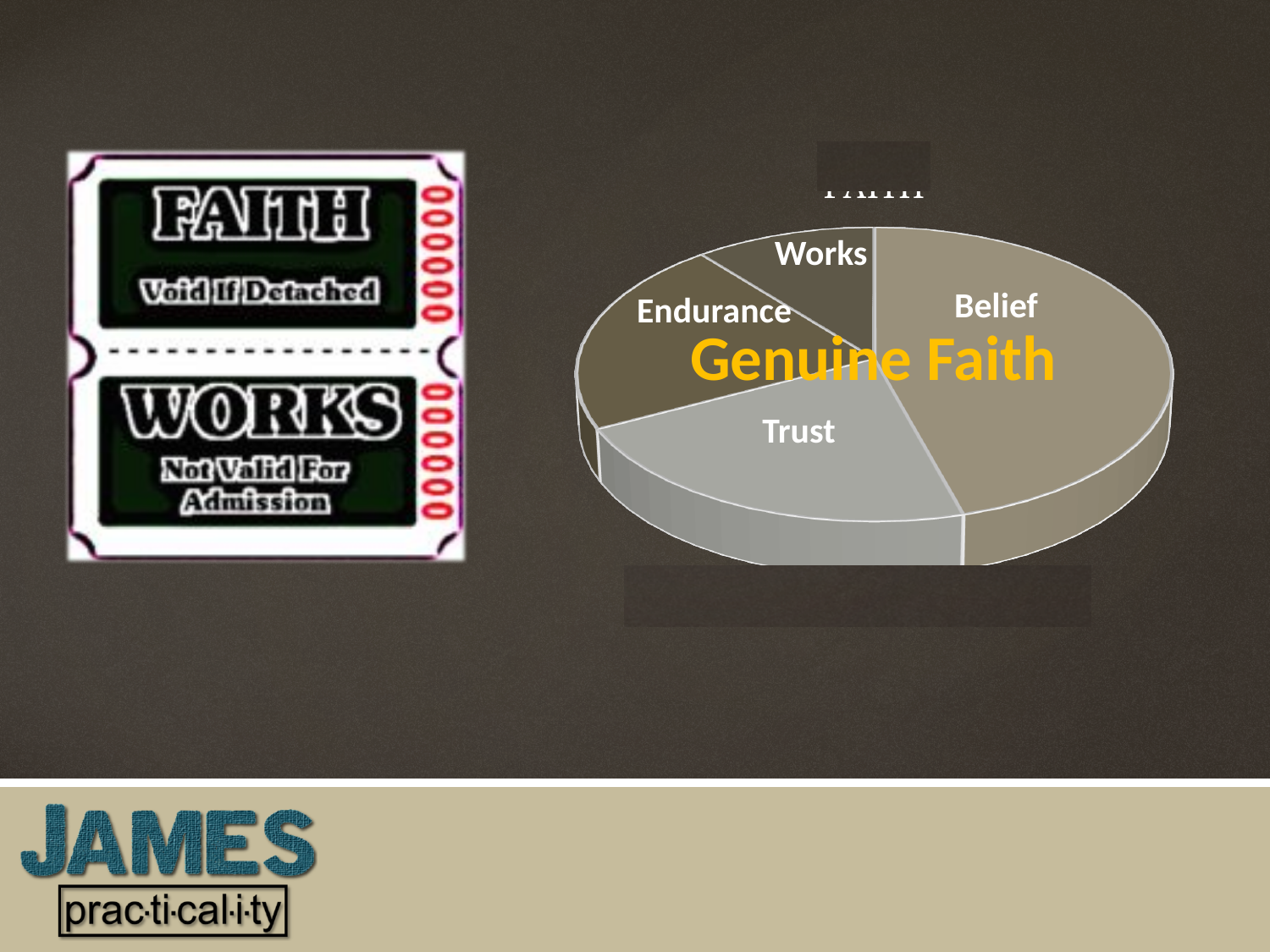
Which slice of the pie chart is the largest? Belief Which slice is larger in the pie chart, Trust or Works? Trust How many slices does the pie chart have? 4 Which slice is larger in the pie chart, Belief or Trust? Belief Which slice is larger in the pie chart, Endurance or Works? Endurance What text is overlaid in large yellow letters across the pie chart? Genuine Faith What are the labels of the four slices in the pie chart? Belief, Trust, Endurance, Works Which slice of the pie chart is the smallest? Works What kind of chart is shown on the slide? pie chart